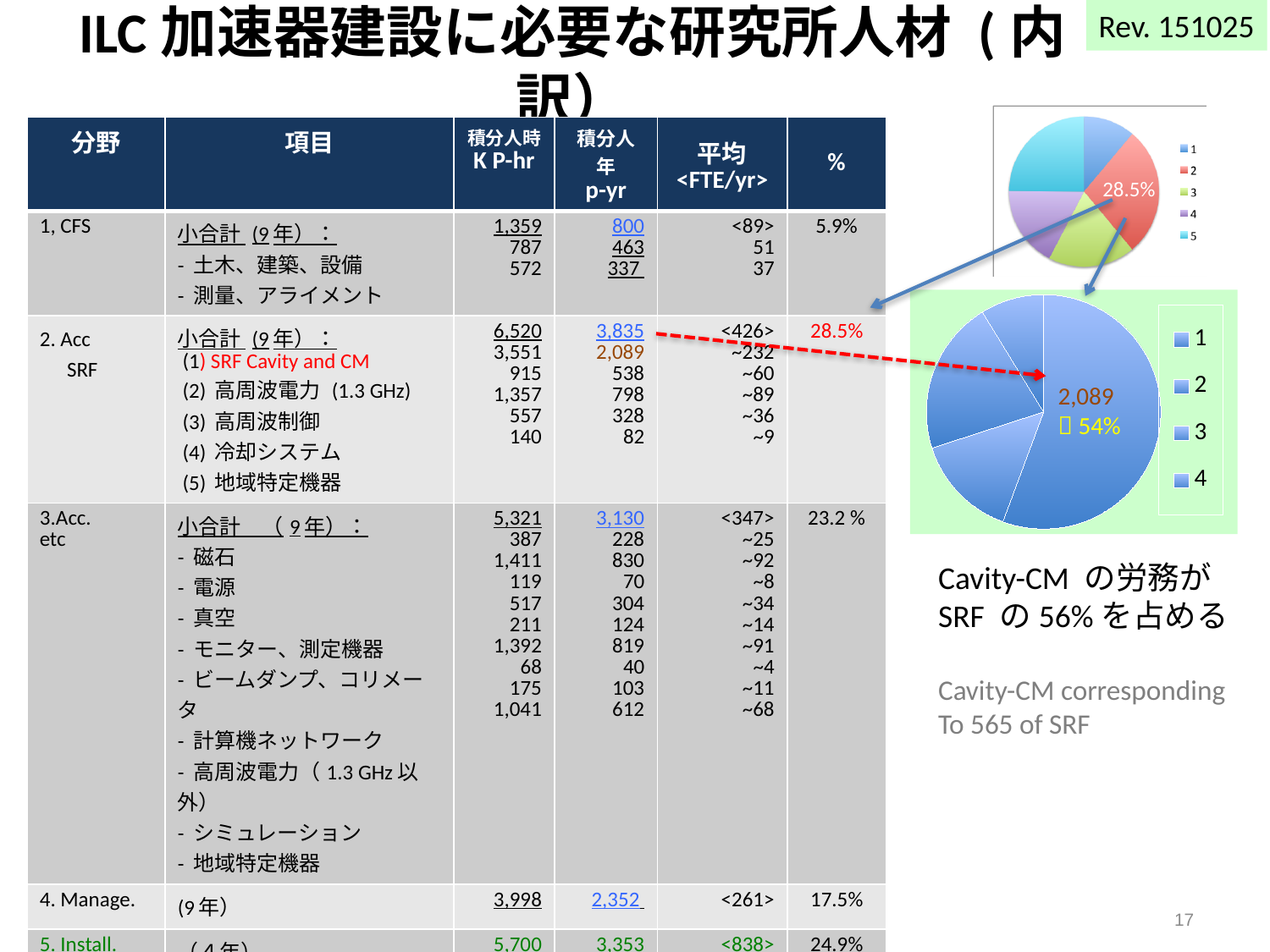
In the top-right pie chart, which legend entry does the slice labeled 28.5% belong to? 2 How many entries does the legend of the pie chart on the green background list? 4 In the top-right pie chart, what percentage label is printed on the red slice? 28.5% How many slices does the pie chart on the green background have? 4 How many slices does the top-right pie chart have? 5 How many entries does the legend of the top-right pie chart list? 5 In the top-right pie chart, is the slice labeled 28.5% greater or less than 50% of the pie? less What kind of chart is the larger chart on the green background on the right side of the slide? pie chart In the pie chart on the green background, is the largest slice greater or less than half of the pie? greater In the pie chart on the green background, what value is printed on the largest slice? 2,089 In the pie chart on the green background, what percentage figure is printed on the largest slice? 54% What kind of chart is the small chart in the top-right corner of the slide? pie chart